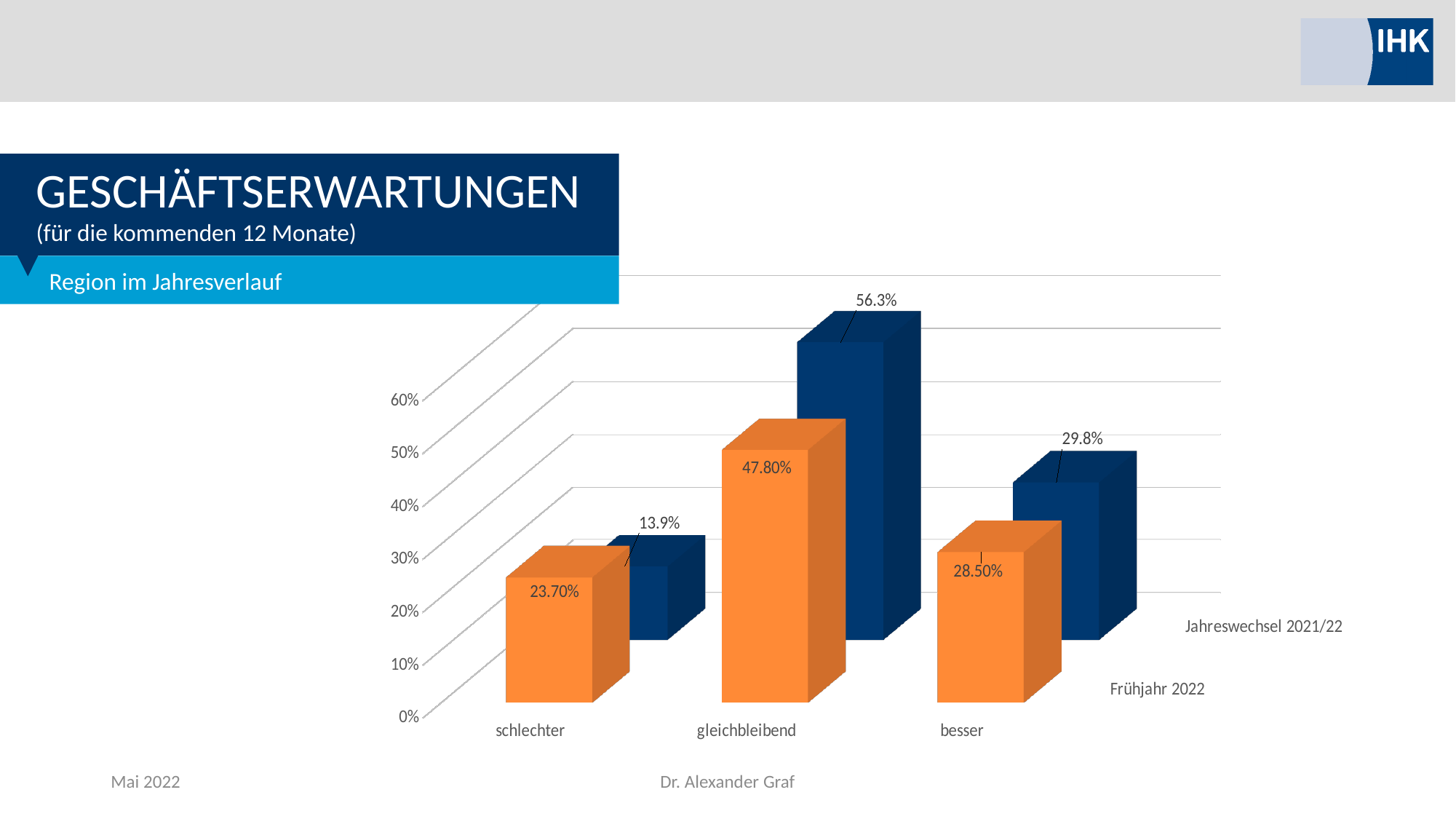
What is the value for "gleichbleibend" in the Frühjahr 2022 series? 47.80% What is the title of the chart on the slide? GESCHÄFTSERWARTUNGEN (für die kommenden 12 Monate) What is the value for "gleichbleibend" in the Jahreswechsel 2021/22 series? 56.3% Which is larger for "gleichbleibend": the Frühjahr 2022 value or the Jahreswechsel 2021/22 value? Jahreswechsel 2021/22 How many series does the chart show? 2 What is the difference between the Jahreswechsel 2021/22 and Frühjahr 2022 values for "schlechter"? 9.8 percentage points What is the value for "schlechter" in the Jahreswechsel 2021/22 series? 13.9% Which category has the lowest value in the Frühjahr 2022 series? schlechter What kind of chart is shown on the slide? Bar chart Which category has the highest value in the Jahreswechsel 2021/22 series? gleichbleibend How many categories are shown on the x axis? 3 What is the value for "besser" in the Frühjahr 2022 series? 28.50%